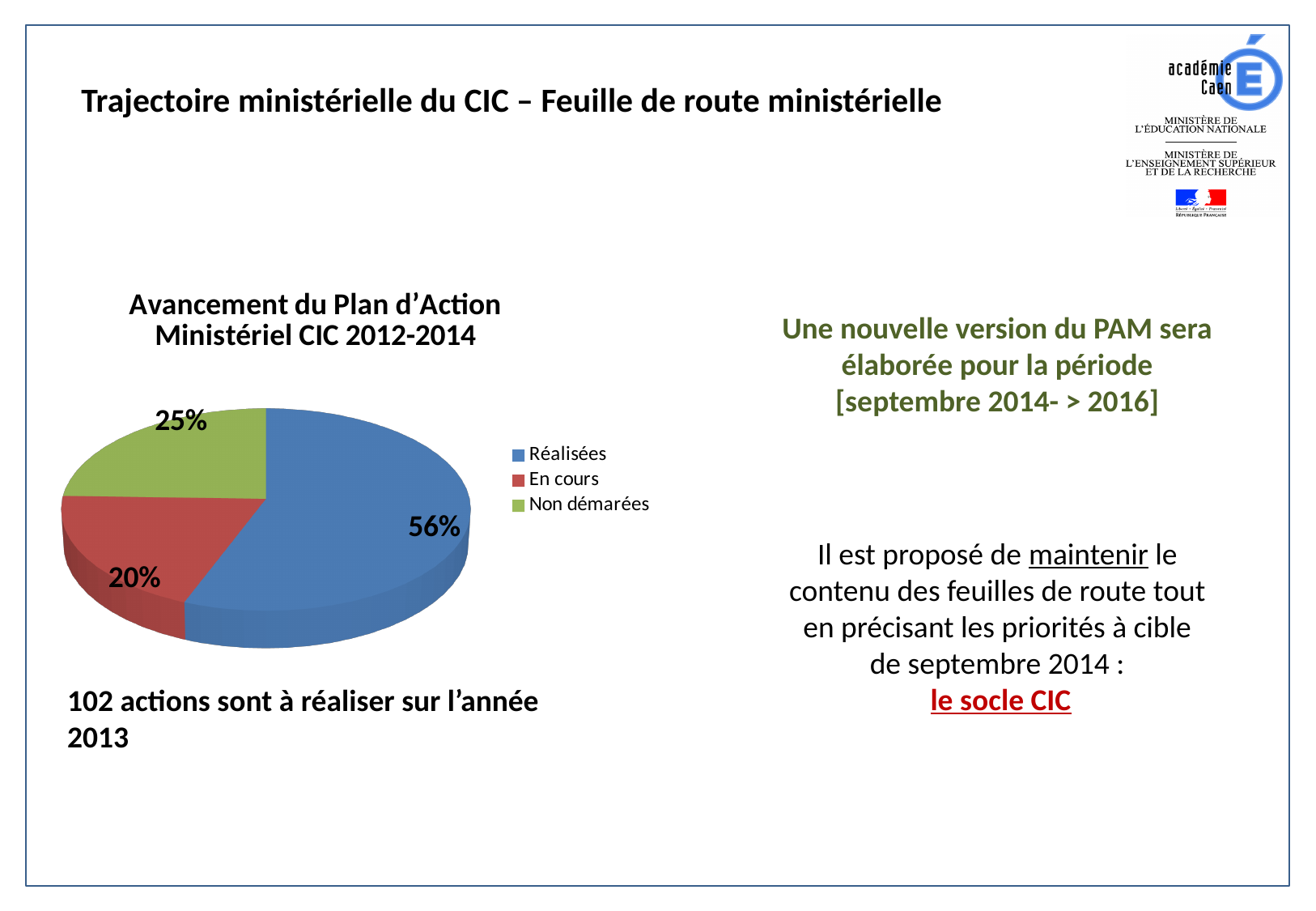
What share of the pie is labelled Réalisées? 56% What kind of chart is shown on the slide? Pie chart Which category has the smallest share of the pie? En cours Which colour represents Réalisées in the legend? Blue How many categories does the pie chart have? 3 Which category has the largest share of the pie? Réalisées What share of the pie is labelled Non démarées? 25% What share of the pie is labelled En cours? 20% What is the difference between the Non démarées share and the En cours share? 5% What is the difference between the Réalisées share and the Non démarées share? 31% Which is larger, the share for En cours or the share for Non démarées? Non démarées What is the title of the chart? Avancement du Plan d'Action Ministériel CIC 2012-2014